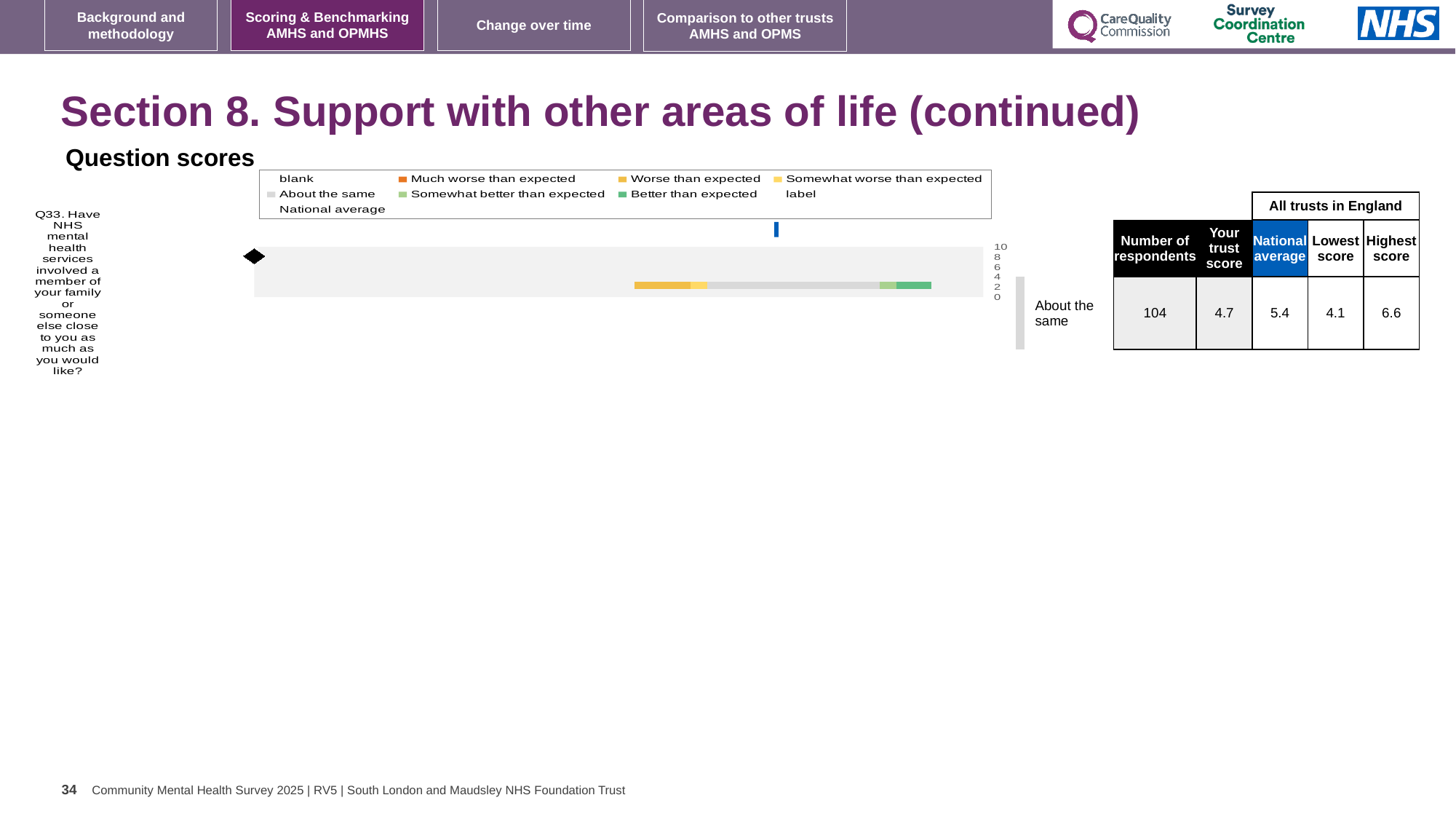
How is the trust's result for Q33 categorised relative to expectations? About the same What is 'Your trust score' for Q33? 4.7 In the chart legend, which colour represents 'Better than expected'? green What kind of chart is shown under 'Question scores'? bar chart What is the lowest score among all trusts in England for Q33? 4.1 Which is larger for Q33, the trust score or the national average? national average What is the number of respondents shown for Q33? 104 What is the highest score among all trusts in England for Q33? 6.6 How many questions (categories) are plotted in the chart? 1 What is the difference between the highest score and the lowest score for Q33? 2.5 What is the national average score for Q33? 5.4 Which question is plotted in the chart? Q33. Have NHS mental health services involved a member of your family or someone else close to you as much as you would like?